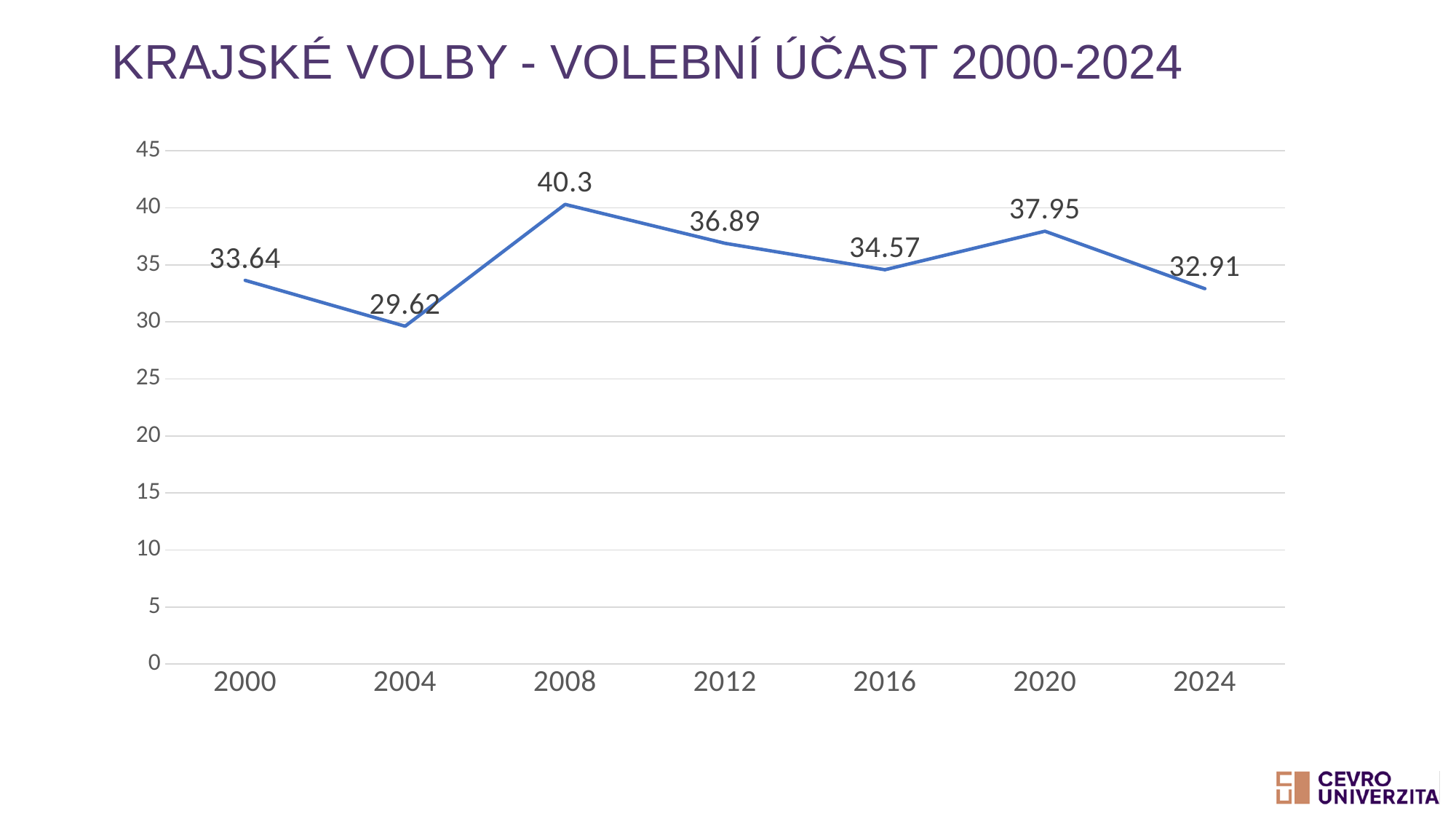
What is the value for 2008? 40.3 Does the value rise or fall from 2020 to 2024? fall Is the value for 2020 greater or less than 35? greater What is the difference between the values for 2008 and 2004? 10.68 Which year has the highest value? 2008 Which year has the lowest value? 2004 How many years are plotted on the x axis? 7 What is the title of the slide? KRAJSKÉ VOLBY - VOLEBNÍ ÚČAST 2000-2024 Which is larger, the value for 2012 or the value for 2016? 2012 What is the value for 2004? 29.62 What is the value for 2024? 32.91 What kind of chart is shown? line chart